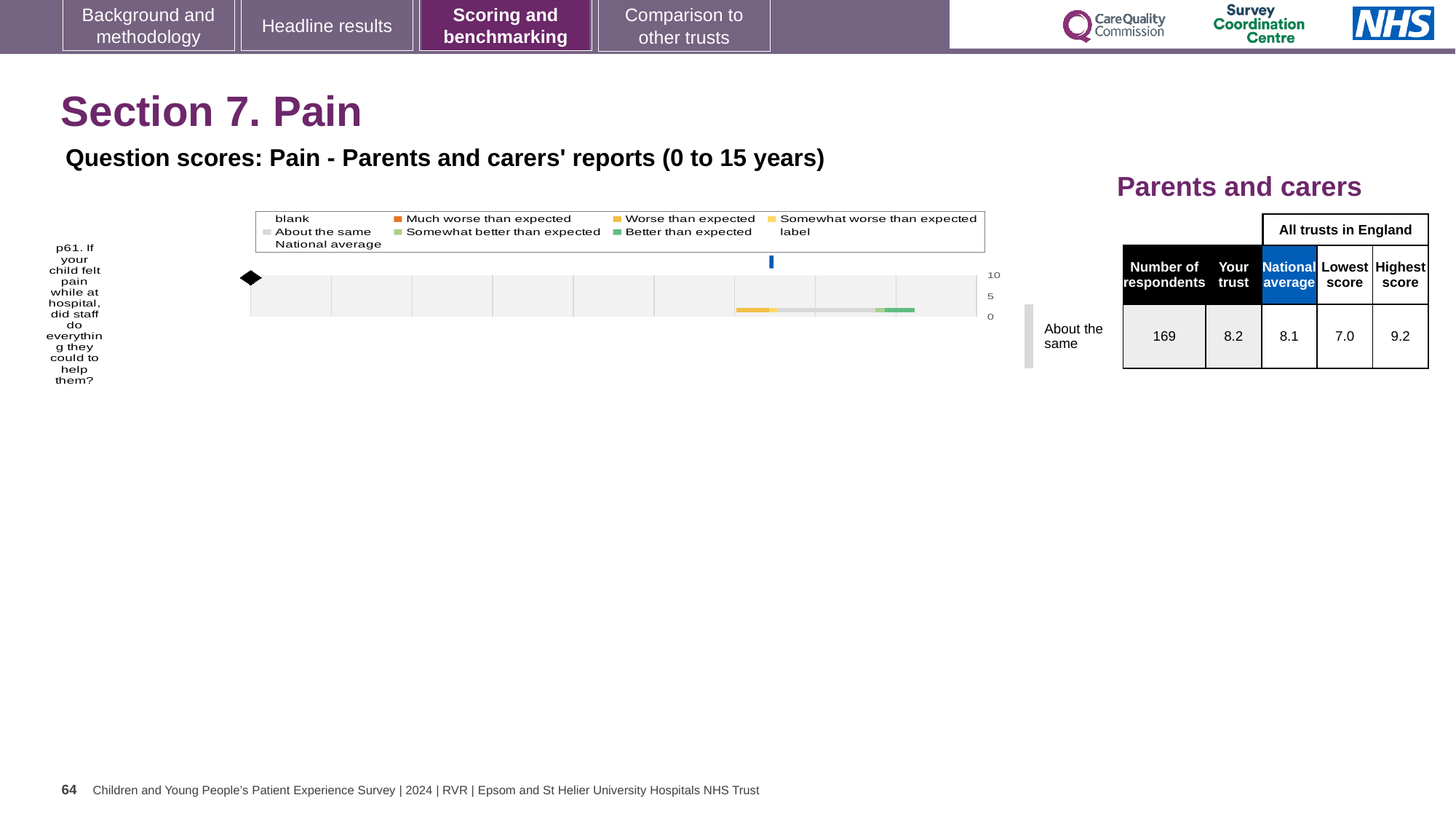
According to the table beside the chart, what is the Highest score among all trusts in England for question p61? 9.2 What is the difference between the Highest score and the Lowest score for question p61? 2.2 How many respondents answered question p61, according to the table beside the chart? 169 According to the table beside the chart, what is the Lowest score among all trusts in England for question p61? 7.0 According to the table beside the chart, what is the score for Your trust on question p61? 8.2 What kind of chart is shown on the slide? bar chart What is the highest value shown on the chart's axis? 10 Which question is plotted in the chart? p61. If your child felt pain while at hospital, did staff do everything they could to help them? Which is larger for question p61: the Your trust score or the National average score? Your trust What benchmarking category is the trust's result for question p61 placed in? About the same According to the table beside the chart, what is the National average score for question p61? 8.1 How many survey questions are plotted in the chart? 1